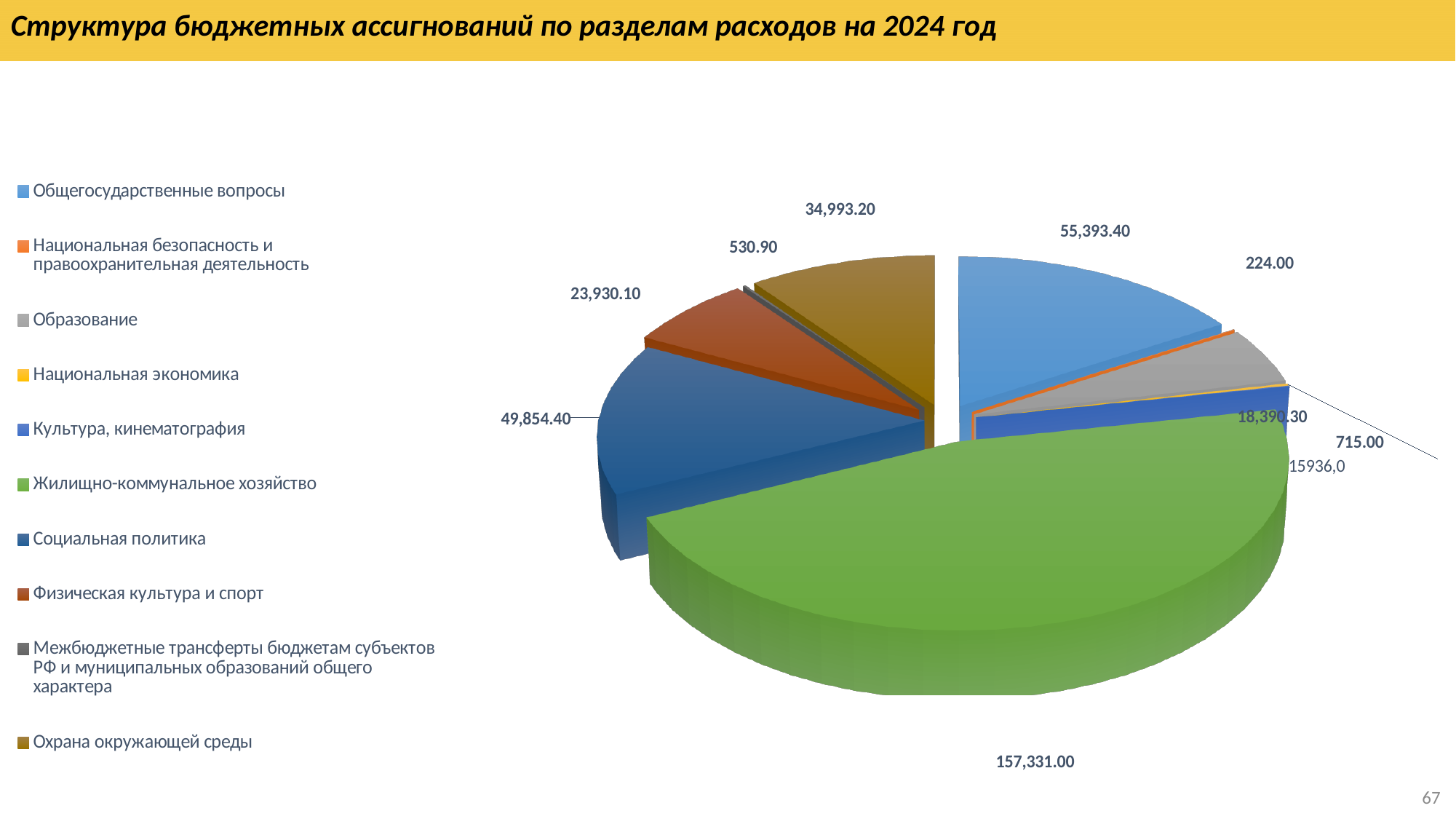
What is the title of the slide containing the pie chart? Структура бюджетных ассигнований по разделам расходов на 2024 год Which category has the largest slice of the pie chart? Жилищно-коммунальное хозяйство How many categories does the legend of the pie chart list? 10 What kind of chart is shown on the slide? pie chart What is the value shown for Социальная политика? 49,854.40 What is the value shown for Общегосударственные вопросы? 55,393.40 What is the difference between the value for Жилищно-коммунальное хозяйство and the value for Общегосударственные вопросы? 101,937.60 Which category has the smallest value in the pie chart? Национальная безопасность и правоохранительная деятельность Which is larger: the value for Общегосударственные вопросы or the value for Социальная политика? Общегосударственные вопросы What is the value shown for Физическая культура и спорт? 23,930.10 What is the value shown for Жилищно-коммунальное хозяйство? 157,331.00 What is the value shown for Охрана окружающей среды? 34,993.20